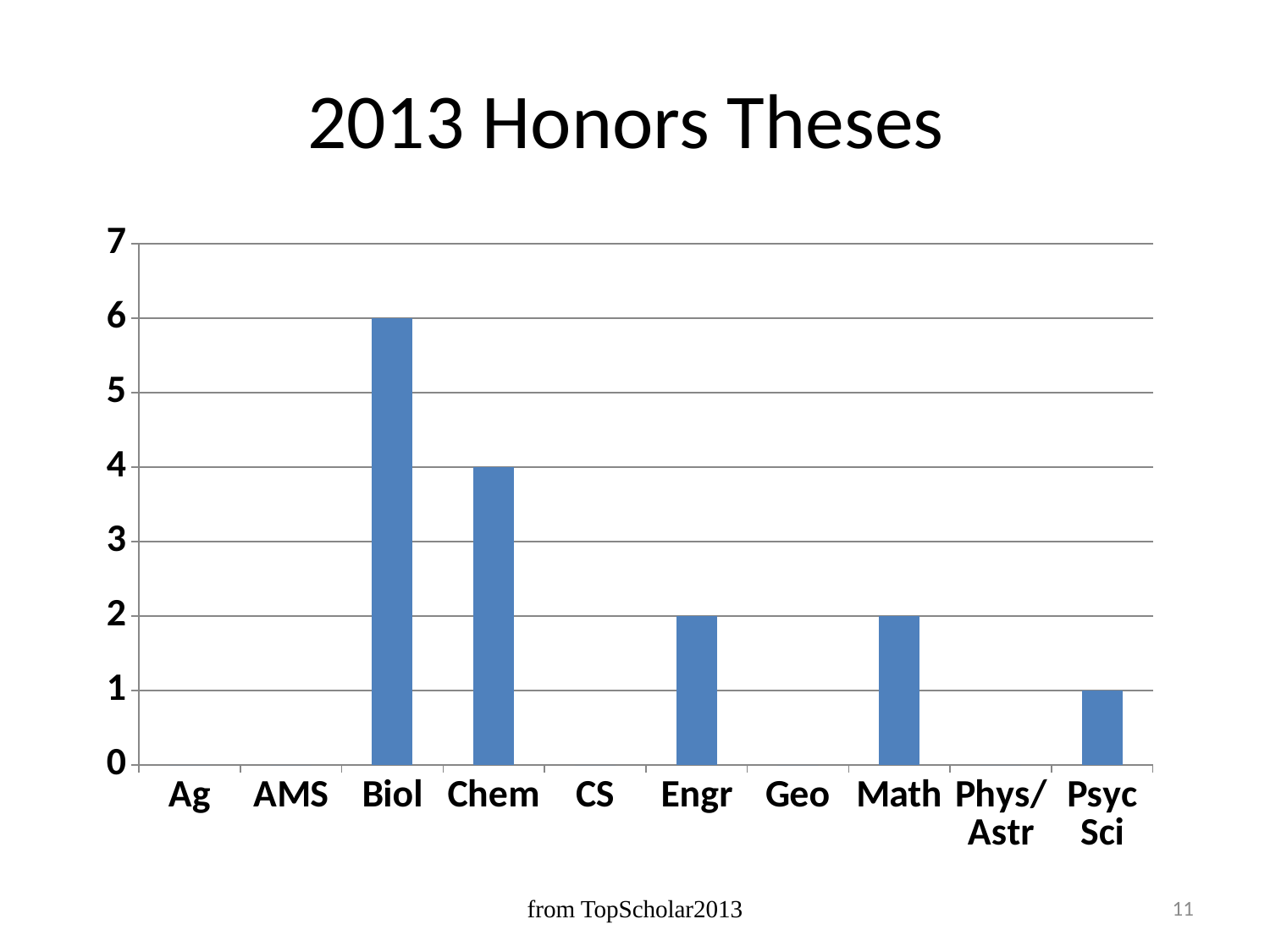
What kind of chart is shown on the slide? bar chart Which is larger, the value for Chem or the value for Math? Chem What is the value for Biol? 6 Which category has the highest value? Biol What is the value for Engr? 2 Is the value for Biol greater or less than 5? greater What is the value for Chem? 4 How many categories are shown on the x axis? 10 What is the title of the chart? 2013 Honors Theses What is the value for Psyc Sci? 1 What is the difference between the values for Biol and Chem? 2 What is the difference between the values for Math and Psyc Sci? 1